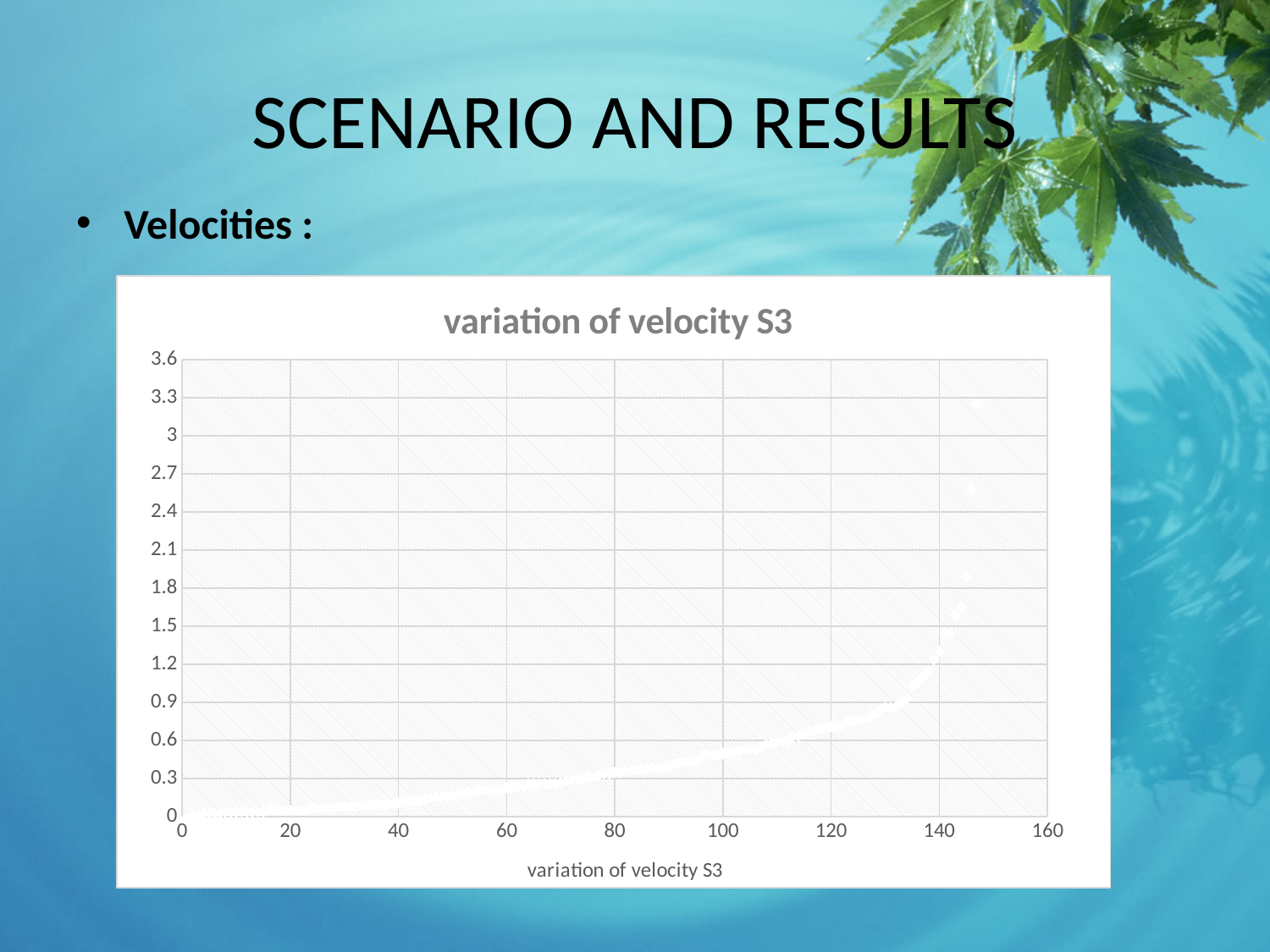
Is the plotted value at x = 120 greater or less than 1.2? less What is the maximum value shown on the y axis? 3.6 Is the plotted value at x = 80 greater or less than 0.6? less What is the title of the chart? variation of velocity S3 Is the highest plotted point greater or less than 3? greater What kind of chart is shown on the slide? scatter chart How many series does the chart's legend list? 1 Do the plotted values rise or fall as the x axis increases? rise